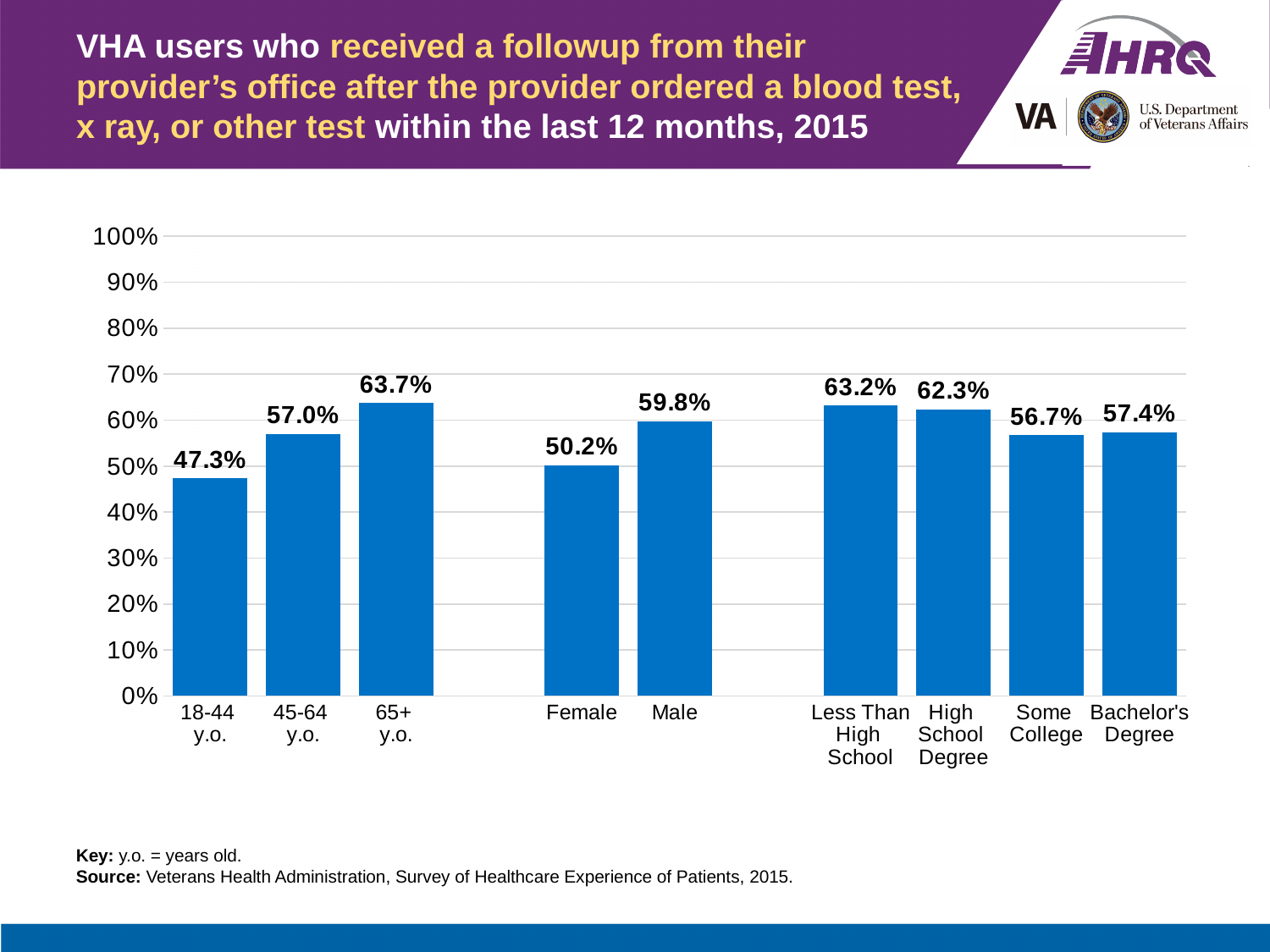
Is the value for 45-64 y.o. greater or less than 50%? greater What is the difference between the values for 65+ y.o. and 18-44 y.o.? 16.4% How many categories are shown on the x axis? 9 Which category has the highest value? 65+ y.o. What kind of chart is shown on the slide? bar chart Do the values rise or fall across the three age groups from 18-44 y.o. to 65+ y.o.? rise What is the difference between the values for Male and Female? 9.6% Which category has the lowest value? 18-44 y.o. What is the value for 18-44 y.o.? 47.3% What is the value for Some College? 56.7% Which is larger, the value for Less Than High School or the value for Some College? Less Than High School What is the value for Female? 50.2%